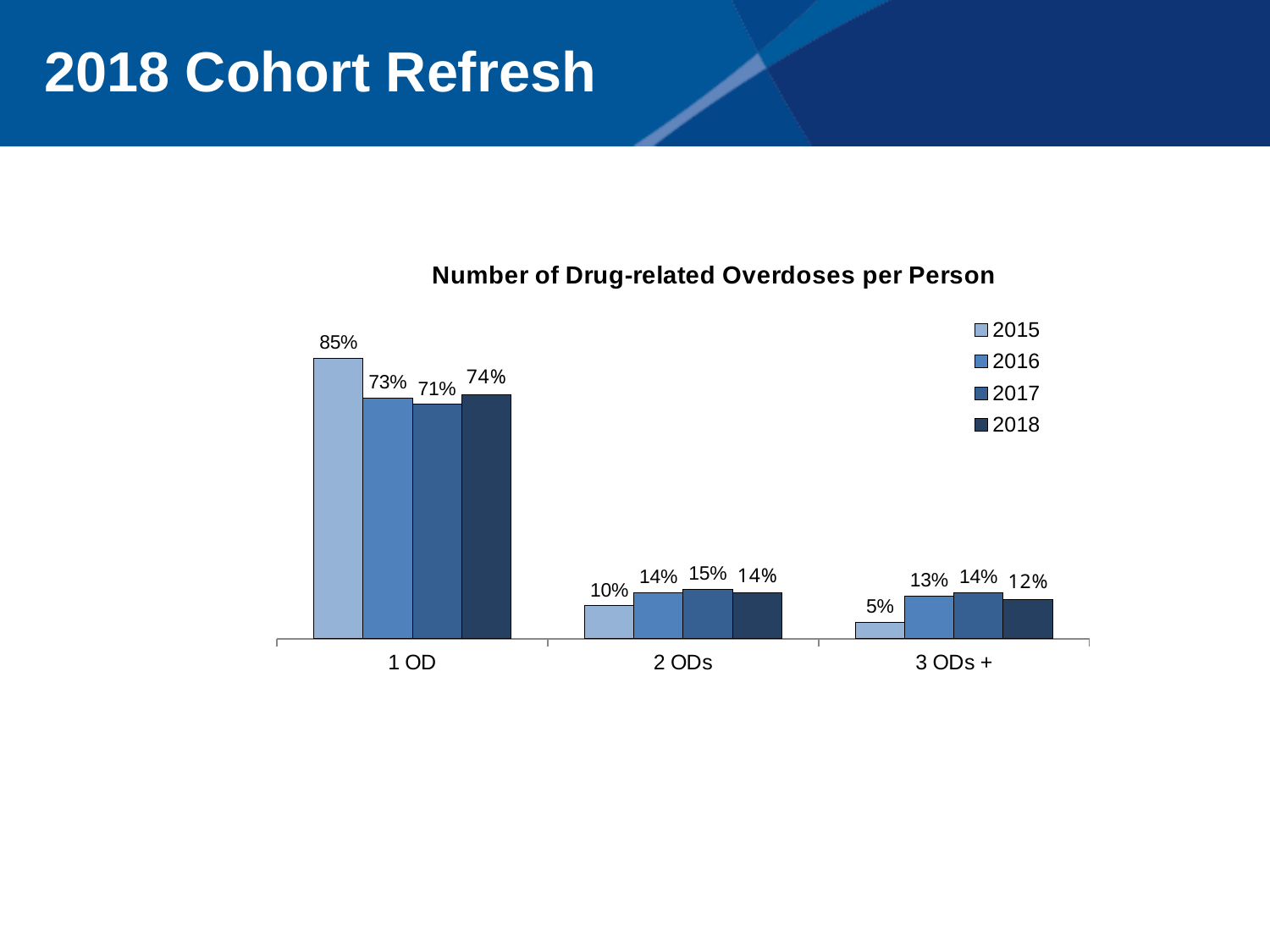
Which year has the highest value in the 1 OD category? 2015 What is the title of the chart? Number of Drug-related Overdoses per Person What is the value for 2015 in the 1 OD category? 85% What is the value for 2017 in the 2 ODs category? 15% How many series does the legend list? 4 Which is larger: the 2016 value for 2 ODs or the 2016 value for 3 ODs +? 2 ODs What kind of chart is shown on the slide? Bar chart Which year has the lowest value in the 3 ODs + category? 2015 How many categories are shown on the x axis? 3 What is the difference between the 2015 and 2018 values in the 3 ODs + category? 7% What is the difference between the 2015 and 2016 values in the 1 OD category? 12% What is the value for 2018 in the 3 ODs + category? 12%